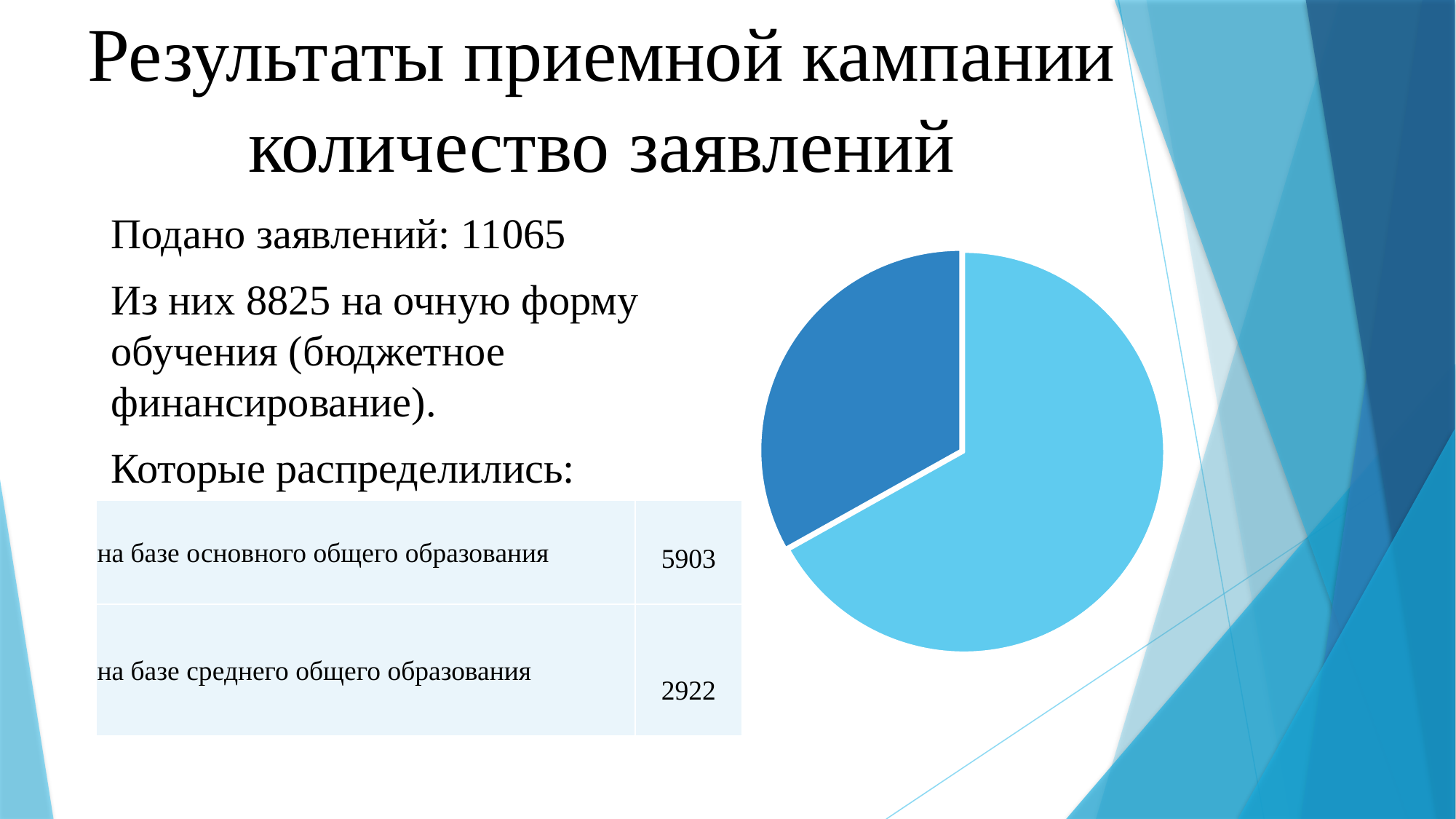
Does the dark blue slice of the pie chart take up more or less than half of the pie? less Are any data labels printed on the pie chart slices? No Does the larger slice of the pie chart take up more or less than half of the pie? more Does the pie chart have a legend? No What kind of chart is shown on the slide? pie chart Which slice of the pie chart is larger, the light blue one or the dark blue one? the light blue one How many slices does the pie chart have? 2